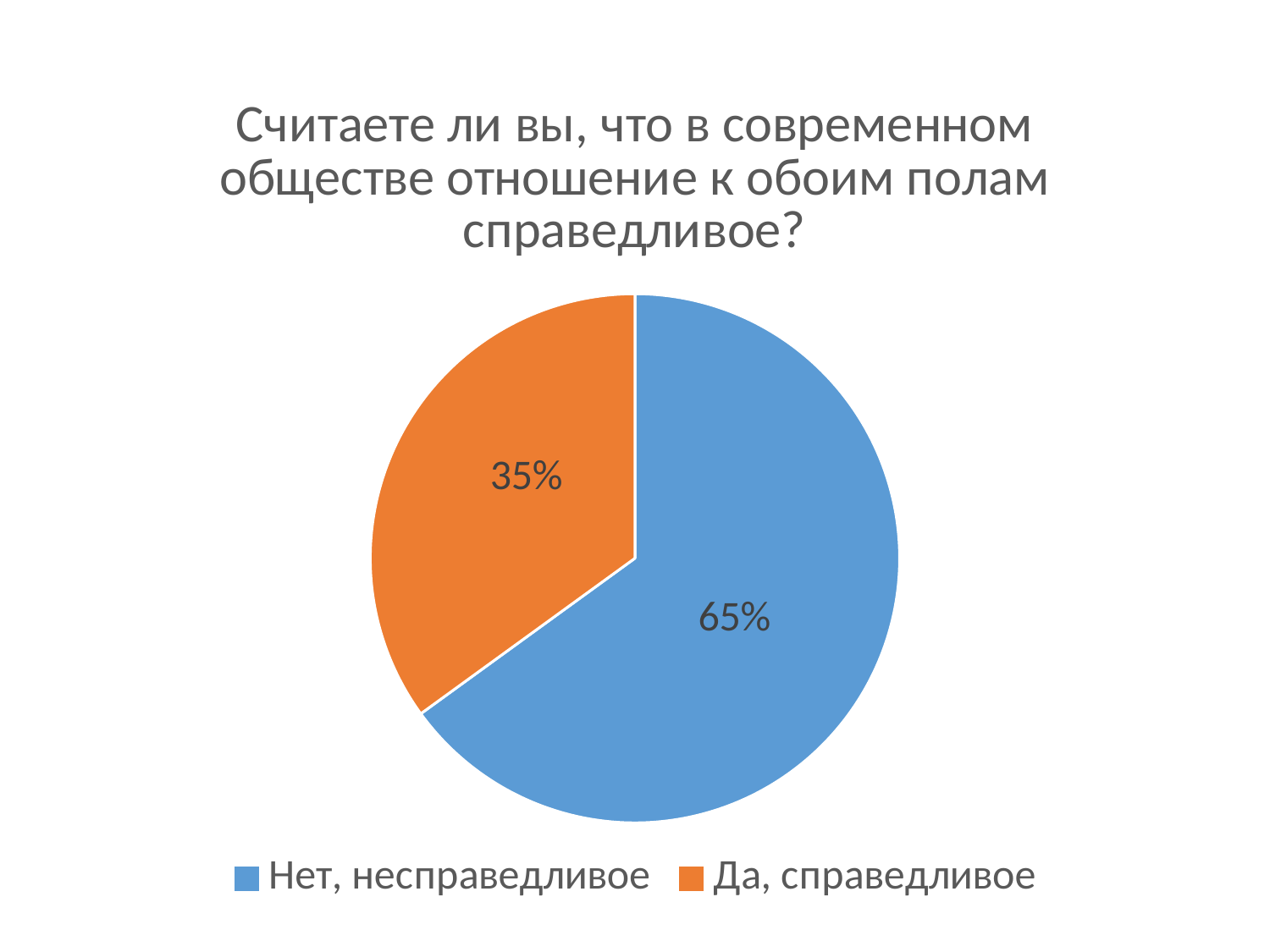
What share of the pie is labelled "Да, справедливое"? 35% Is the share for "Нет, несправедливое" greater or less than 50%? greater Which is larger: the "Да, справедливое" slice or the "Нет, несправедливое" slice? Нет, несправедливое Which slice is the largest? Нет, несправедливое Which slice is the smallest? Да, справедливое What share of the pie is labelled "Нет, несправедливое"? 65% How many slices does the pie chart have? 2 What colour is the "Да, справедливое" slice? orange What is the difference in percentage points between the "Нет, несправедливое" and "Да, справедливое" slices? 30 What is the title of the chart? Считаете ли вы, что в современном обществе отношение к обоим полам справедливое? How many entries does the legend list? 2 What kind of chart is shown on the slide? pie chart